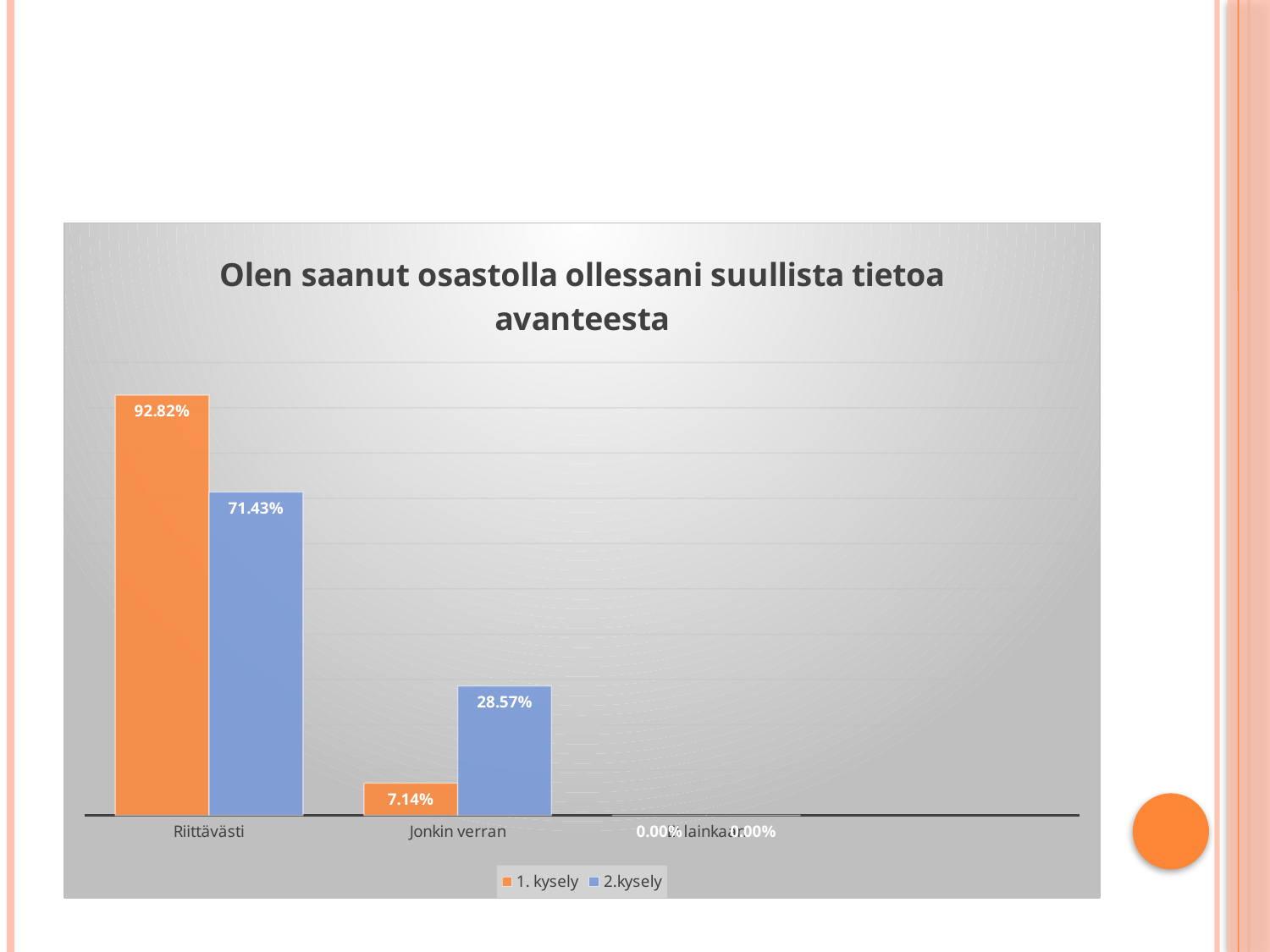
Which is larger for Jonkin verran: 1. kysely or 2.kysely? 2.kysely What is the value for 2.kysely in the Riittävästi category? 71.43% What is the difference between the 2.kysely and 1. kysely values for Jonkin verran? 21.43% Which category has the highest value for 1. kysely? Riittävästi What is the value for 1. kysely in the Riittävästi category? 92.82% How many categories are shown on the x axis? 3 What kind of chart is shown on the slide? Bar chart What is the difference between the 1. kysely and 2.kysely values for Riittävästi? 21.39% How many series does the legend list? 2 What is the value for 2.kysely in the Jonkin verran category? 28.57% What is the value for 1. kysely in the Jonkin verran category? 7.14% Which category has the highest value for 2.kysely? Riittävästi